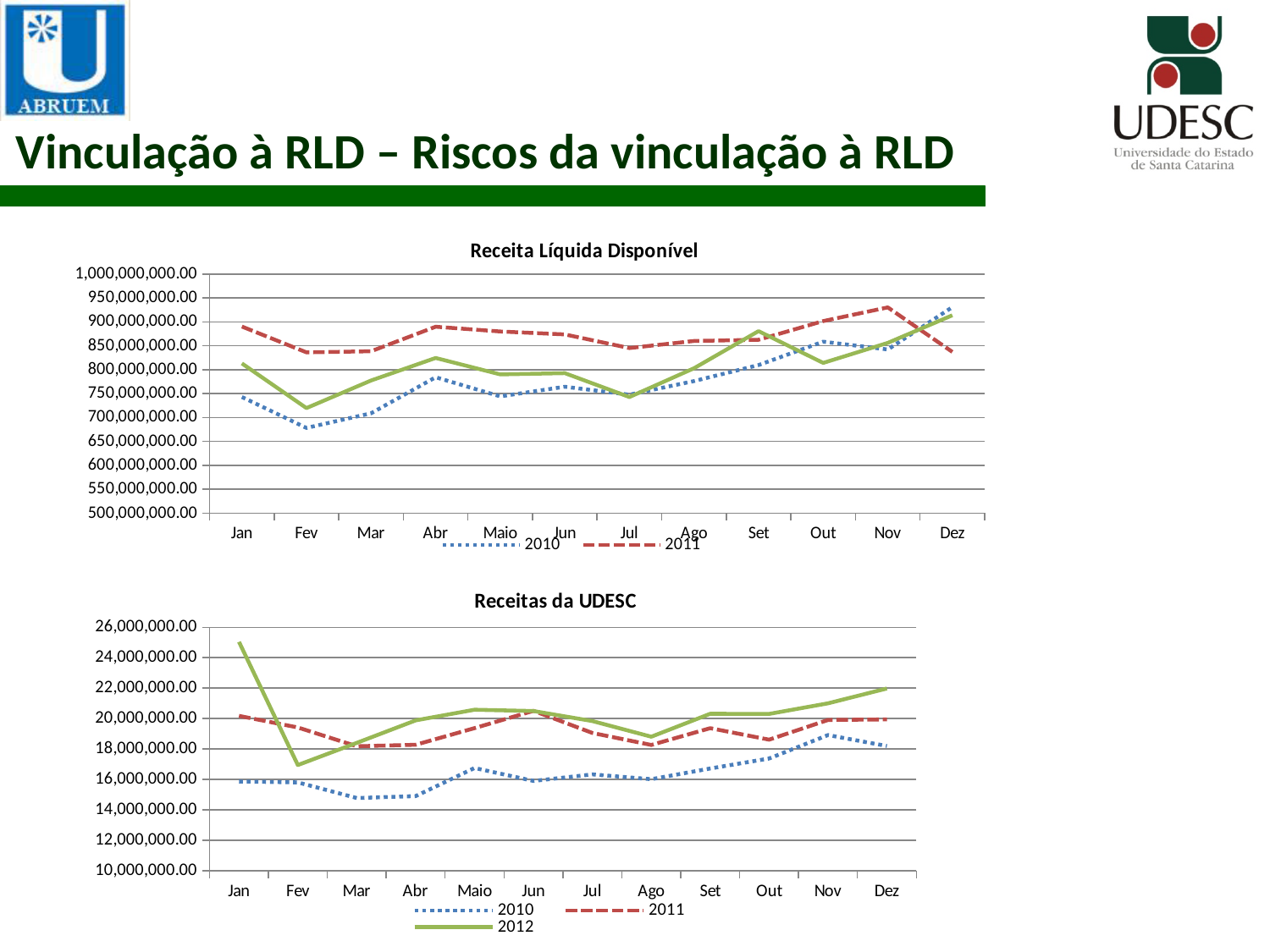
How many months are shown on the x axis of the 'Receitas da UDESC' chart? 12 In the 'Receita Líquida Disponível' chart, which month has the highest value for the 2011 series? Nov How many series does the legend of the 'Receitas da UDESC' chart list? 3 In the 'Receitas da UDESC' chart, is the 2010 value for Mar greater or less than 16,000,000.00? less What type of chart is the 'Receita Líquida Disponível' chart? line chart In the 'Receita Líquida Disponível' chart, which month has the lowest value for the 2010 series? Fev In the 'Receita Líquida Disponível' chart, is the 2011 value for Nov greater or less than 900,000,000.00? greater In the 'Receitas da UDESC' chart, is the 2012 value for Jan greater or less than 24,000,000.00? greater In the 'Receita Líquida Disponível' chart, which series has the larger value in Jan, 2010 or 2011? 2011 What is the title of the lower chart on the slide? Receitas da UDESC In the 'Receitas da UDESC' chart, which series has the larger value in Jan, 2010 or 2012? 2012 In the 'Receitas da UDESC' chart, which month has the highest value for the 2012 series? Jan